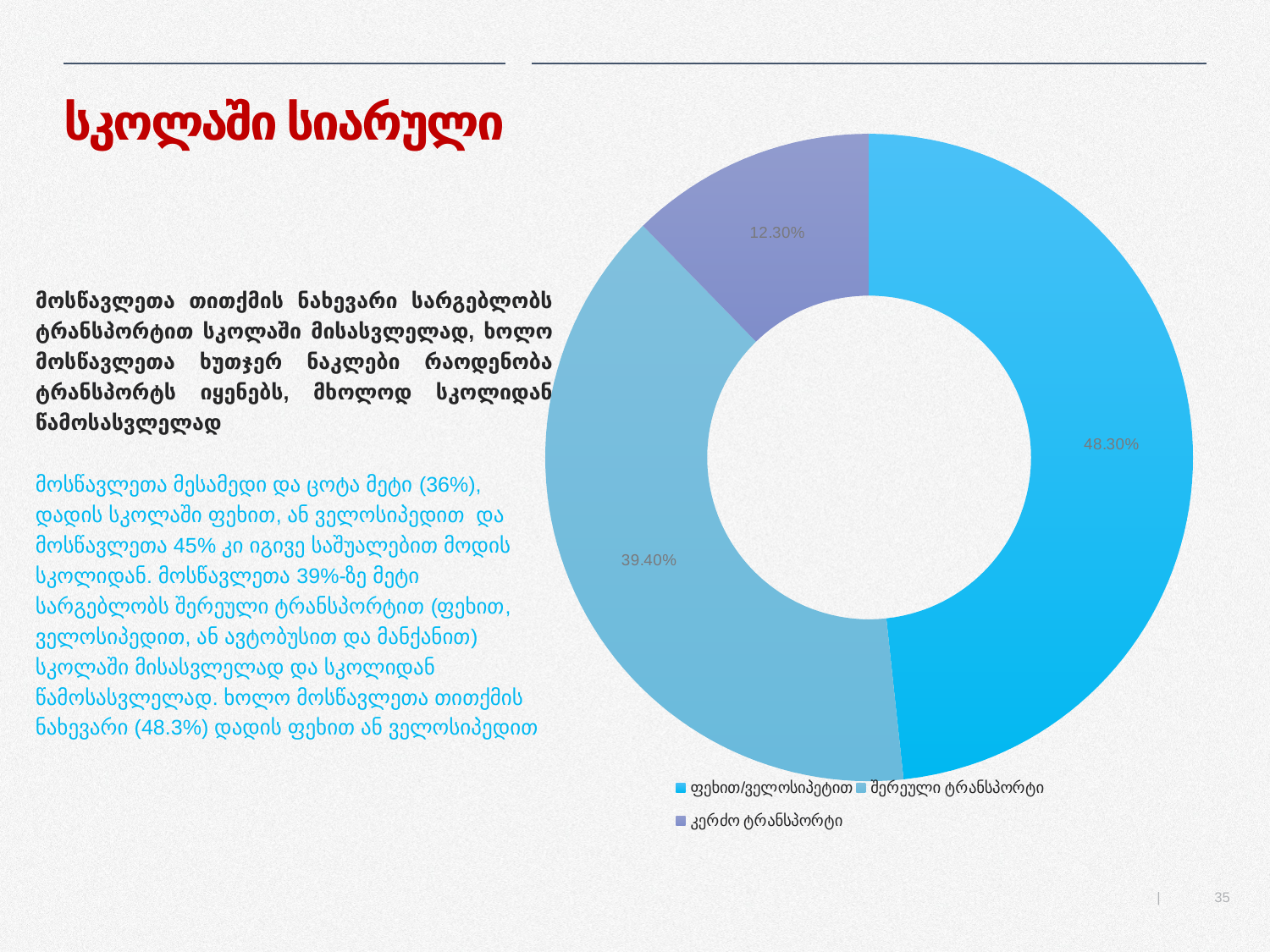
What is the difference between the values for შერეული ტრანსპორტი and კერძო ტრანსპორტი? 27.10% Which category has the smallest share of the chart? კერძო ტრანსპორტი Which is larger: the share for შერეული ტრანსპორტი or the share for კერძო ტრანსპორტი? შერეული ტრანსპორტი What type of chart is shown on the slide? Doughnut (pie) chart How many slices does the chart have? 3 Which category has the largest share of the chart? ფეხით/ველოსიპედით What is the difference between the values for ფეხით/ველოსიპედით and შერეული ტრანსპორტი? 8.90% What is the value shown for კერძო ტრანსპორტი? 12.30% How many entries does the legend list? 3 What is the value shown for ფეხით/ველოსიპედით? 48.30% What is the value shown for შერეული ტრანსპორტი? 39.40% What is the title of the slide containing the chart? სკოლაში სიარული